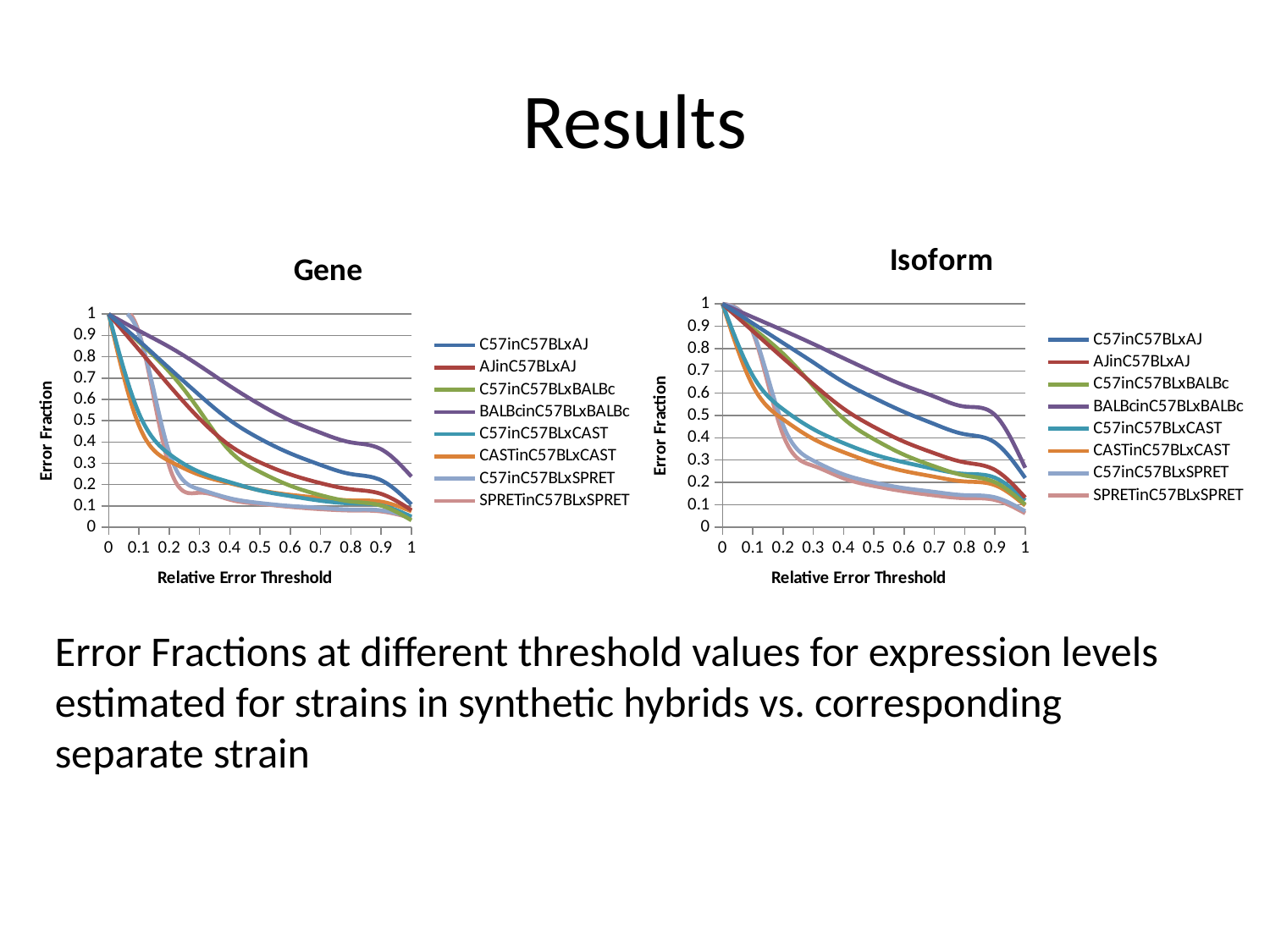
In the Gene chart, what is the Error Fraction for every series at a Relative Error Threshold of 0? 1 In the Isoform chart, is the Error Fraction for C57inC57BLxAJ at a Relative Error Threshold of 0.5 greater or less than 0.4? greater In the Gene chart, at a Relative Error Threshold of 0.5, which has the larger Error Fraction: BALBcinC57BLxBALBc or C57inC57BLxCAST? BALBcinC57BLxBALBc In the Gene chart, which series has the highest Error Fraction at a Relative Error Threshold of 0.5? BALBcinC57BLxBALBc What type of chart is the Gene chart? line chart In the Isoform chart, which series has the highest Error Fraction at a Relative Error Threshold of 0.5? BALBcinC57BLxBALBc In the Isoform chart, is the Error Fraction for SPRETinC57BLxSPRET at a Relative Error Threshold of 0.5 greater or less than 0.3? less In the Gene chart, is the Error Fraction for BALBcinC57BLxBALBc at a Relative Error Threshold of 0.3 greater or less than 0.6? greater How many series does the legend of the Isoform chart list? 8 What is the x-axis title of the Gene chart? Relative Error Threshold In the Isoform chart, do the Error Fraction values rise or fall as the Relative Error Threshold increases? fall